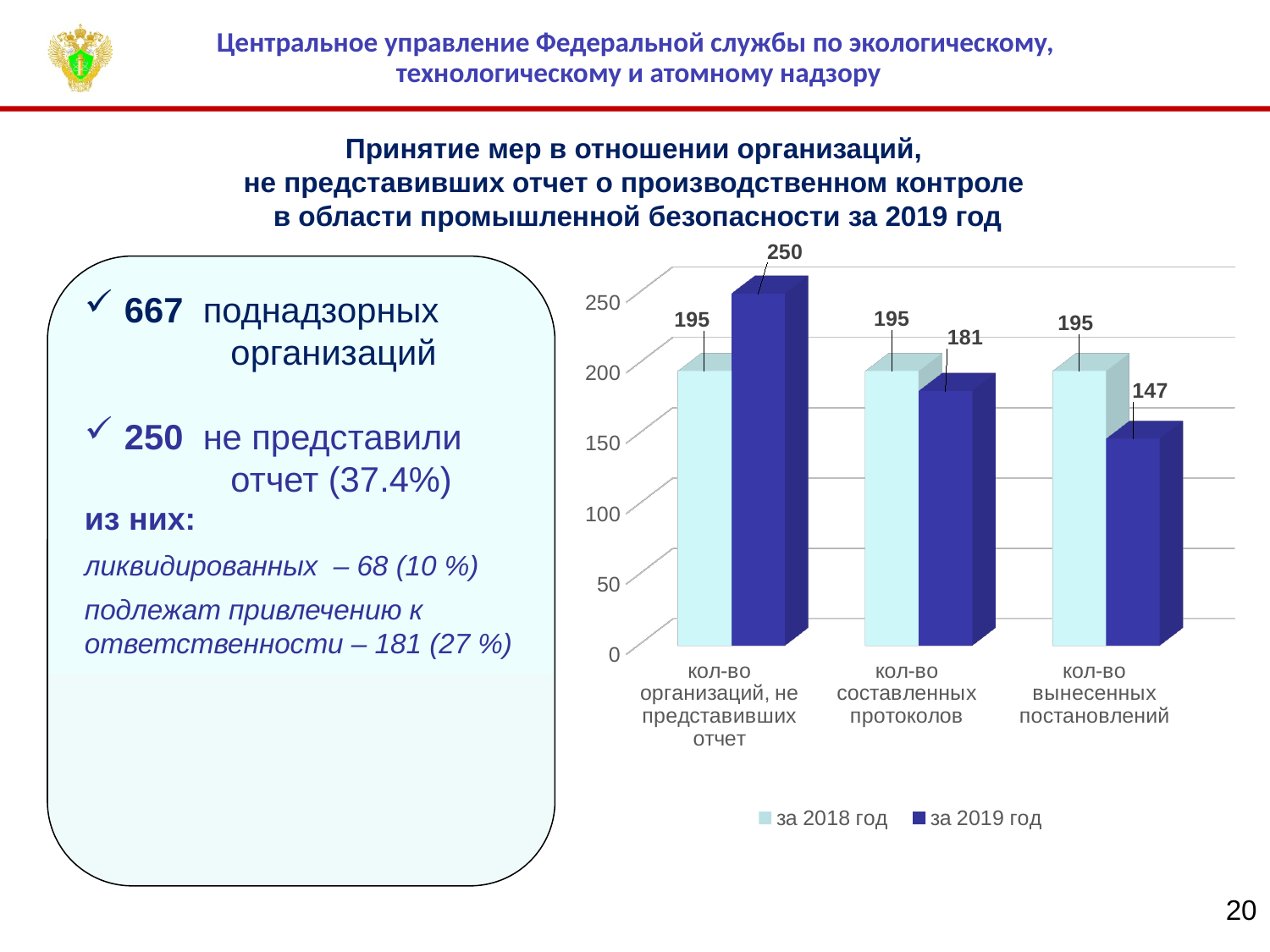
Which category has the highest value in the 'за 2019 год' series? кол-во организаций, не представивших отчет What kind of chart is shown on the slide? bar chart How many series does the chart legend list? 2 Which is larger for 'кол-во составленных протоколов': the 'за 2018 год' value or the 'за 2019 год' value? за 2018 год What is the difference between the 'за 2019 год' and 'за 2018 год' values for 'кол-во организаций, не представивших отчет'? 55 What is the value for 'кол-во вынесенных постановлений' in the 'за 2018 год' series? 195 How many categories are shown on the x axis of the chart? 3 Do the 'за 2019 год' values rise or fall from left to right across the categories? fall What is the value for 'кол-во организаций, не представивших отчет' in the 'за 2019 год' series? 250 Which category has the lowest value in the 'за 2019 год' series? кол-во вынесенных постановлений What is the value for 'кол-во составленных протоколов' in the 'за 2019 год' series? 181 What is the difference between the 'за 2018 год' and 'за 2019 год' values for 'кол-во вынесенных постановлений'? 48